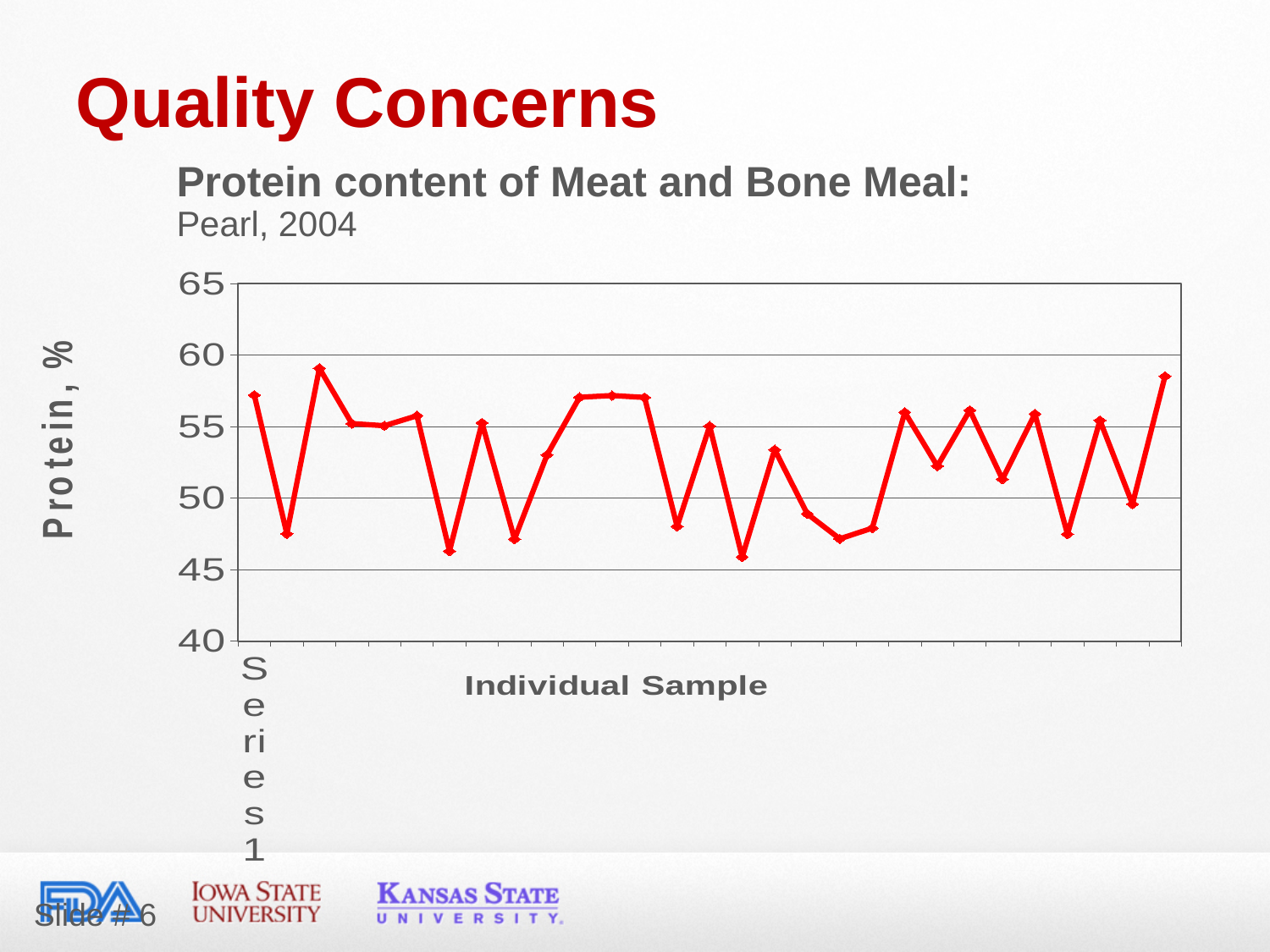
What is the label of the y axis? Protein, % Is the value for the second sample greater or less than 50? less Is the value for the first sample greater or less than 55? greater Does the protein content rise steadily, fall steadily, or fluctuate across the samples? fluctuate Are all plotted values greater or less than 45? greater How many sample points are plotted on the line? 29 How many series does the legend list? 1 What kind of chart is shown on the slide? line chart What is the title of the chart? Protein content of Meat and Bone Meal: Pearl, 2004